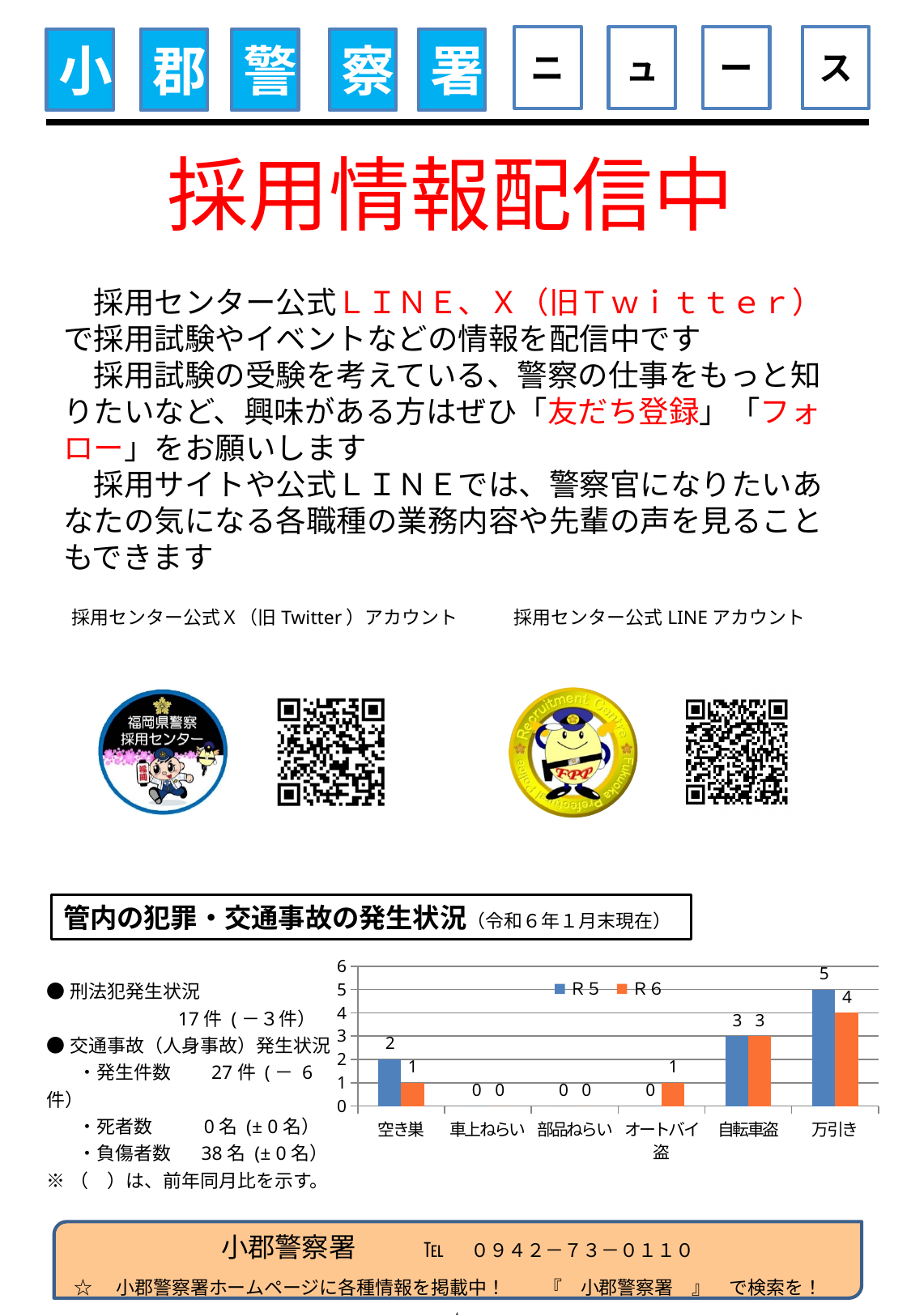
Which category has the highest R5 value? 万引き What is the R5 value for 空き巣? 2 What is the difference between the R5 and R6 values for 万引き? 1 What is the R5 value for 自転車盗? 3 How many categories are shown on the x axis of the chart? 6 What type of chart is shown on the slide? bar chart Which category has the highest R6 value? 万引き What is the R6 value for 万引き? 4 What is the R6 value for オートバイ盗? 1 What are the names of the two series in the legend? R5 and R6 For 空き巣, which is larger, the R5 value or the R6 value? R5 How many series does the chart legend list? 2